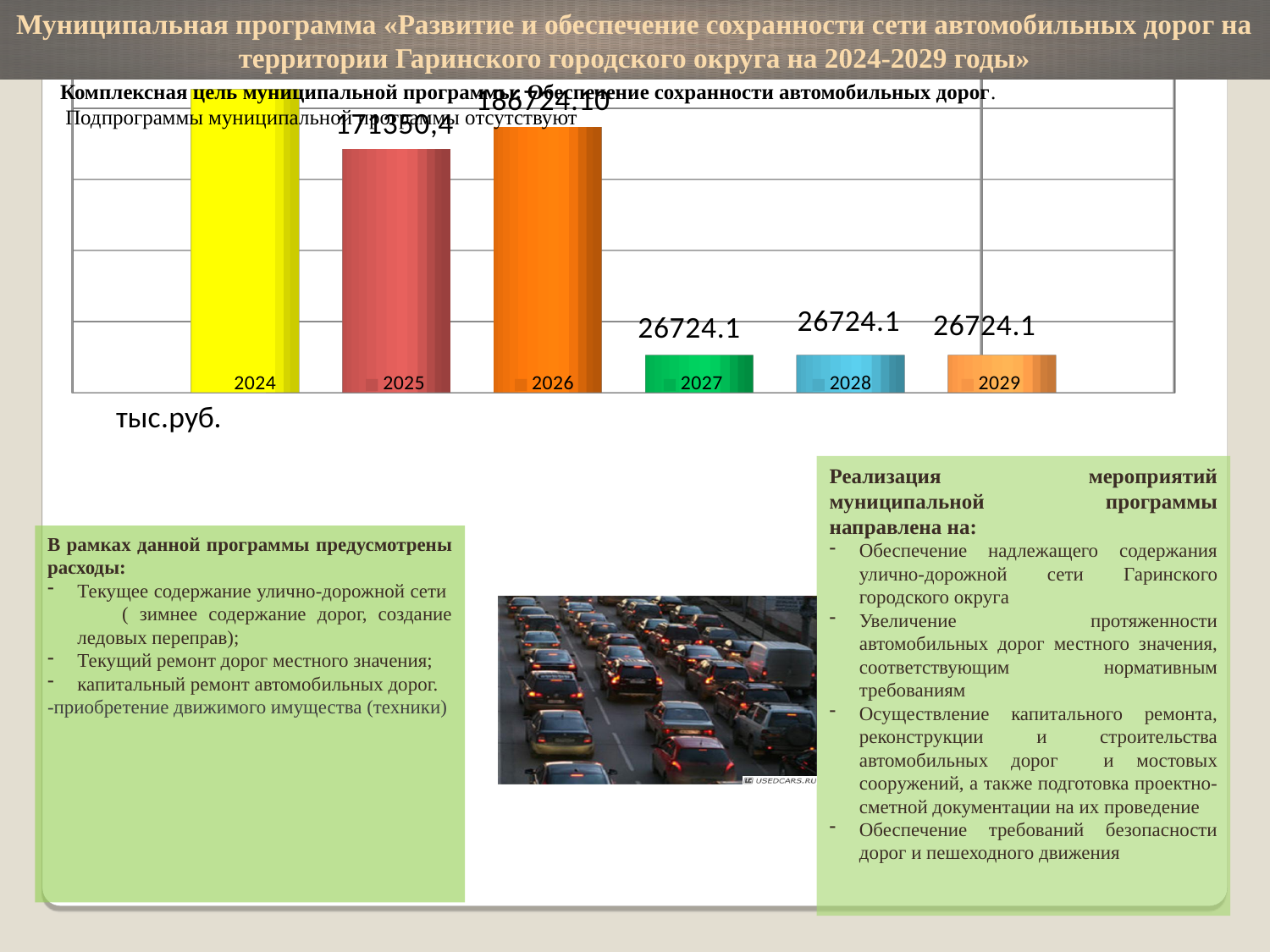
Which is larger, the value for 2025 or the value for 2026? 2026 What is the value shown for 2026 on the chart? 186724.10 What is the value shown for 2025 on the chart? 171359,4 What is the value shown for 2027 on the chart? 26724.1 What unit is indicated below the chart? тыс.руб. Which is larger, the value for 2026 or the value for 2028? 2026 What is the difference between the values for 2026 and 2027? 160000.0 Do the values rise or fall from 2026 to 2027? fall Which year has the tallest bar on the chart? 2024 What is the value shown for 2029 on the chart? 26724.1 What kind of chart is shown on the slide? bar chart How many years (bars) are shown on the chart? 6